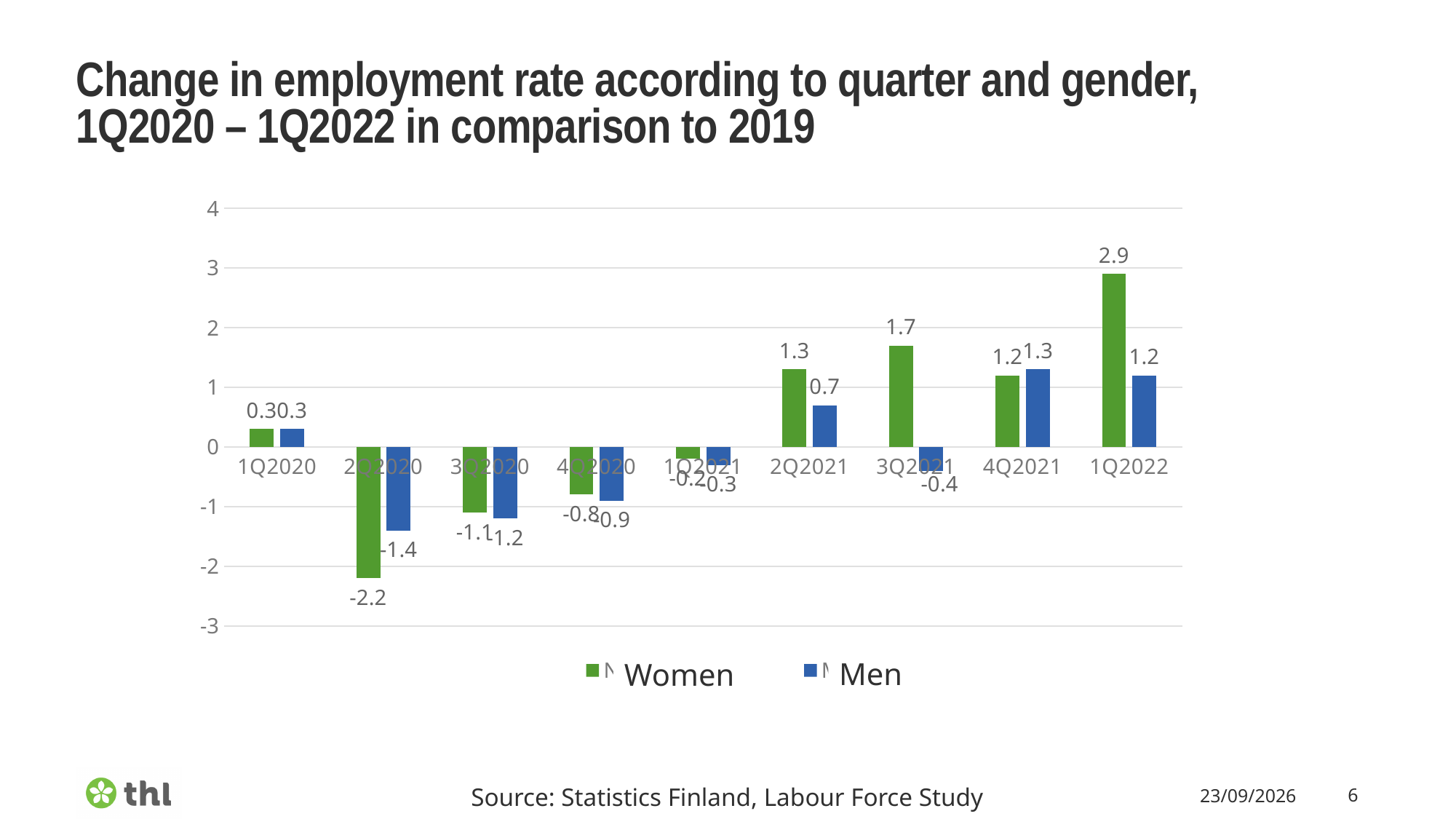
How many quarters are shown on the x axis? 9 What kind of chart is shown on the slide? Bar chart What is the value for Men in 3Q2021? -0.4 In which quarter is the Women value highest? 1Q2022 In which quarter is the Men value lowest? 2Q2020 How many series does the legend list? 2 Which is larger in 3Q2021, the Women value or the Men value? Women What is the value for Men in 2Q2020? -1.4 What is the value for Women in 1Q2022? 2.9 What is the value for Women in 2Q2021? 1.3 In which quarter is the Women value lowest? 2Q2020 What is the difference between the Women and Men values in 1Q2022? 1.7